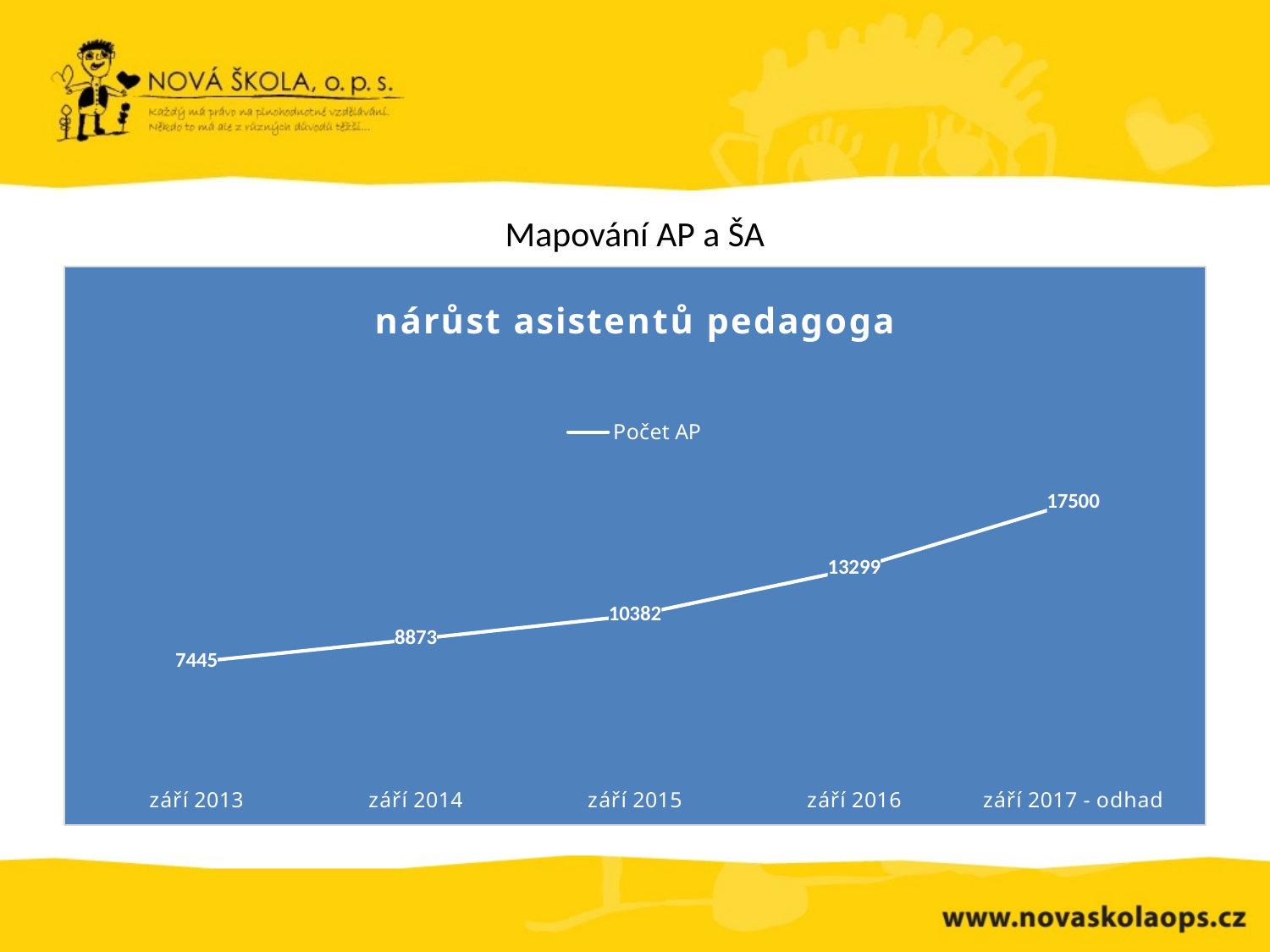
Which category has the highest value? září 2017 - odhad Which is larger, the value for září 2014 or the value for září 2016? září 2016 What is the value for září 2015? 10382 What is the value for září 2013? 7445 What kind of chart is shown? line chart What is the difference between the values for září 2016 and září 2015? 2917 Which category has the lowest value? září 2013 Do the values rise or fall from září 2013 to září 2017 - odhad? rise What is the value for září 2017 - odhad? 17500 How many points are plotted on the line? 5 How many series does the legend list? 1 What is the difference between the values for září 2017 - odhad and září 2013? 10055